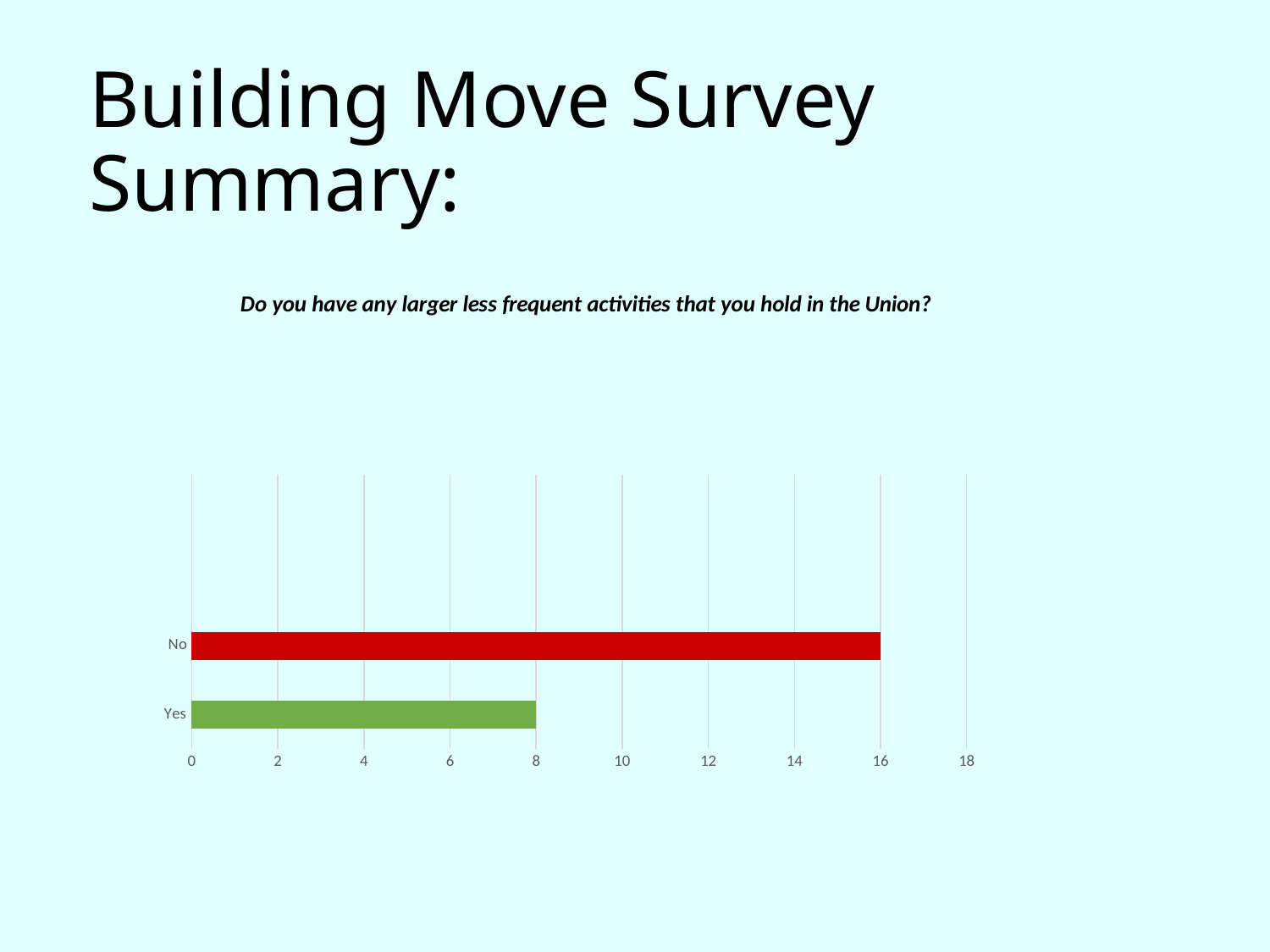
Which category has the lowest value? Yes What is the value for "Yes"? 8 What colour is the bar for "Yes"? green Which is larger, the value for "Yes" or the value for "No"? No Is the value for "No" greater or less than 10? greater Which category has the highest value? No What is the difference between the values for "No" and "Yes"? 8 Is the value for "Yes" greater or less than 12? less What is the title of the chart? Do you have any larger less frequent activities that you hold in the Union? What is the value for "No"? 16 What kind of chart is shown on the slide? bar chart How many categories are shown in the chart? 2